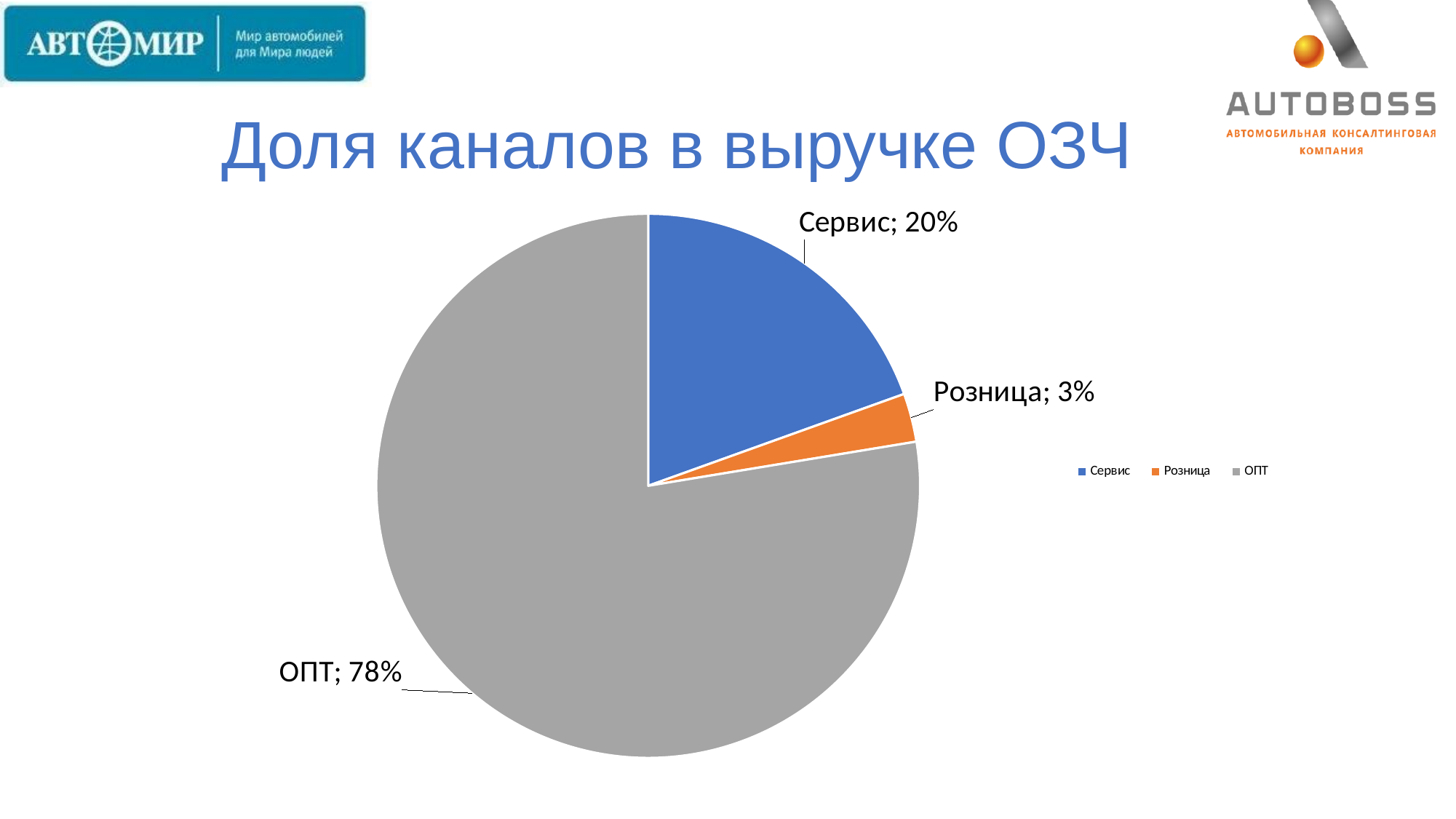
What is the difference in percentage points between the shares of ОПТ and Сервис? 58 Which has a larger share, Сервис or Розница? Сервис What share of the pie does Розница have? 3% Which category has the smallest share of the pie? Розница What kind of chart is shown on the slide? Pie chart What is the title of the slide? Доля каналов в выручке ОЗЧ Which category has the largest share of the pie? ОПТ What share of the pie does Сервис have? 20% How many categories are shown in the pie chart? 3 What is the difference in percentage points between the shares of Сервис and Розница? 17 What share of the pie does ОПТ have? 78% What colour is the ОПТ slice in the pie chart? Grey